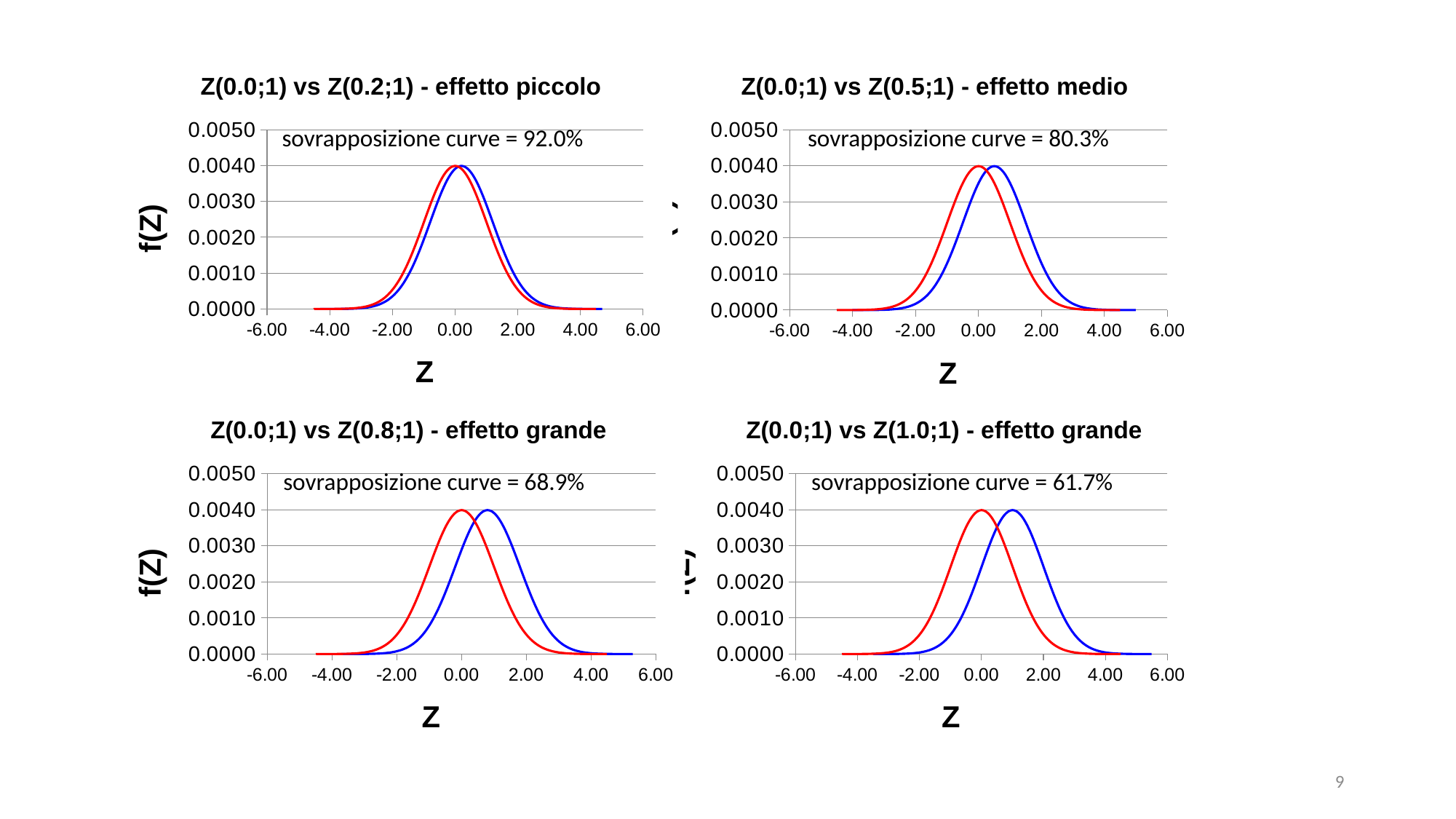
In the bottom-right chart "Z(0.0;1) vs Z(1.0;1) - effetto grande", what is the value of "sovrapposizione curve"? 61.7% Across the four charts, which chart reports the lowest "sovrapposizione curve" value? Z(0.0;1) vs Z(1.0;1) - effetto grande In the top-left chart "Z(0.0;1) vs Z(0.2;1) - effetto piccolo", is the peak value of the red curve greater or less than 0.0030? greater Across the four charts, which chart reports the highest "sovrapposizione curve" value? Z(0.0;1) vs Z(0.2;1) - effetto piccolo In the top-right chart "Z(0.0;1) vs Z(0.5;1) - effetto medio", what is the value of "sovrapposizione curve"? 80.3% In the bottom-left chart "Z(0.0;1) vs Z(0.8;1) - effetto grande", what is the value of "sovrapposizione curve"? 68.9% What kind of chart is the top-left chart titled "Z(0.0;1) vs Z(0.2;1) - effetto piccolo"? line chart Which chart has the larger "sovrapposizione curve" value: the top-right chart "Z(0.0;1) vs Z(0.5;1) - effetto medio" or the bottom-left chart "Z(0.0;1) vs Z(0.8;1) - effetto grande"? Z(0.0;1) vs Z(0.5;1) - effetto medio In the top-left chart "Z(0.0;1) vs Z(0.2;1) - effetto piccolo", what is the value of "sovrapposizione curve"? 92.0% What is the label on the x axis of the bottom-left chart "Z(0.0;1) vs Z(0.8;1) - effetto grande"? Z How many curves are plotted in the bottom-right chart "Z(0.0;1) vs Z(1.0;1) - effetto grande"? 2 What is the difference between the "sovrapposizione curve" value in the top-left chart and the one in the bottom-right chart? 30.3 percentage points